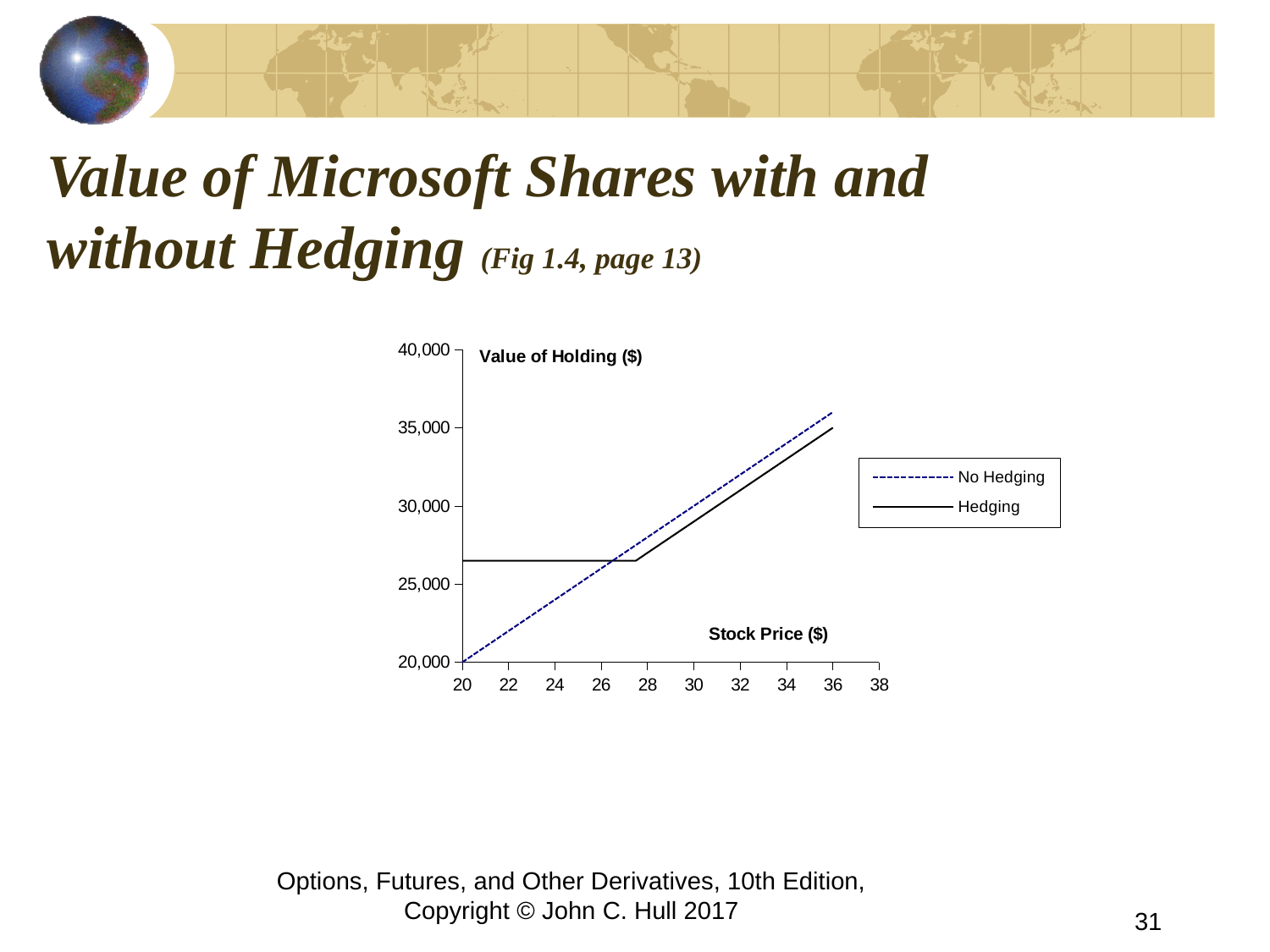
Does the No Hedging line rise or fall as the stock price increases? rise Is the value of holding for No Hedging at a stock price of 34 greater or less than 30,000? greater At a stock price of 34, which series has the higher value of holding, Hedging or No Hedging? No Hedging What is the title of the vertical axis? Value of Holding ($) What is the value of holding for No Hedging at a stock price of 20? 20,000 What are the two series named in the legend? No Hedging and Hedging What kind of chart is shown on the slide? line chart Is the value of holding for Hedging at a stock price of 22 greater or less than 25,000? greater Is the value of holding for No Hedging at a stock price of 22 greater or less than 25,000? less At a stock price of 22, which series has the higher value of holding, Hedging or No Hedging? Hedging How many series does the legend list? 2